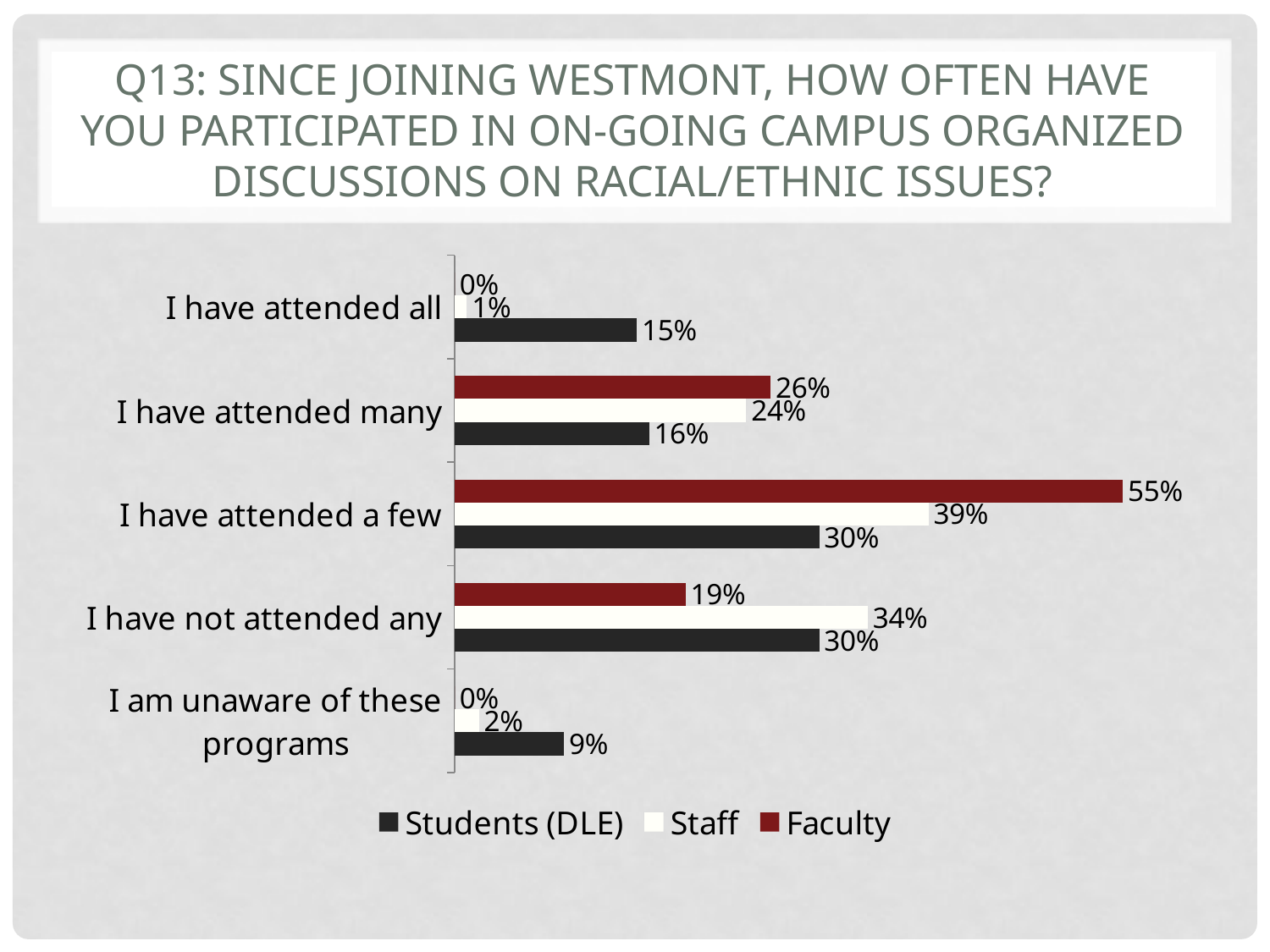
What percentage of Staff said "I have not attended any"? 34% Which colour represents Faculty in the chart? Dark red What percentage of Faculty said "I have attended a few"? 55% What percentage of Students (DLE) said "I have attended all"? 15% How many series does the legend list? 3 How many response categories are shown on the chart? 5 What kind of chart is shown on the slide? Bar chart For "I have attended many", which group has the larger value, Staff or Students (DLE)? Staff Which category has the highest value for Staff? I have attended a few What is the difference between the Faculty and Students (DLE) values for "I have attended a few"? 25% What percentage of Faculty said "I am unaware of these programs"? 0% Which category has the lowest value for Students (DLE)? I am unaware of these programs